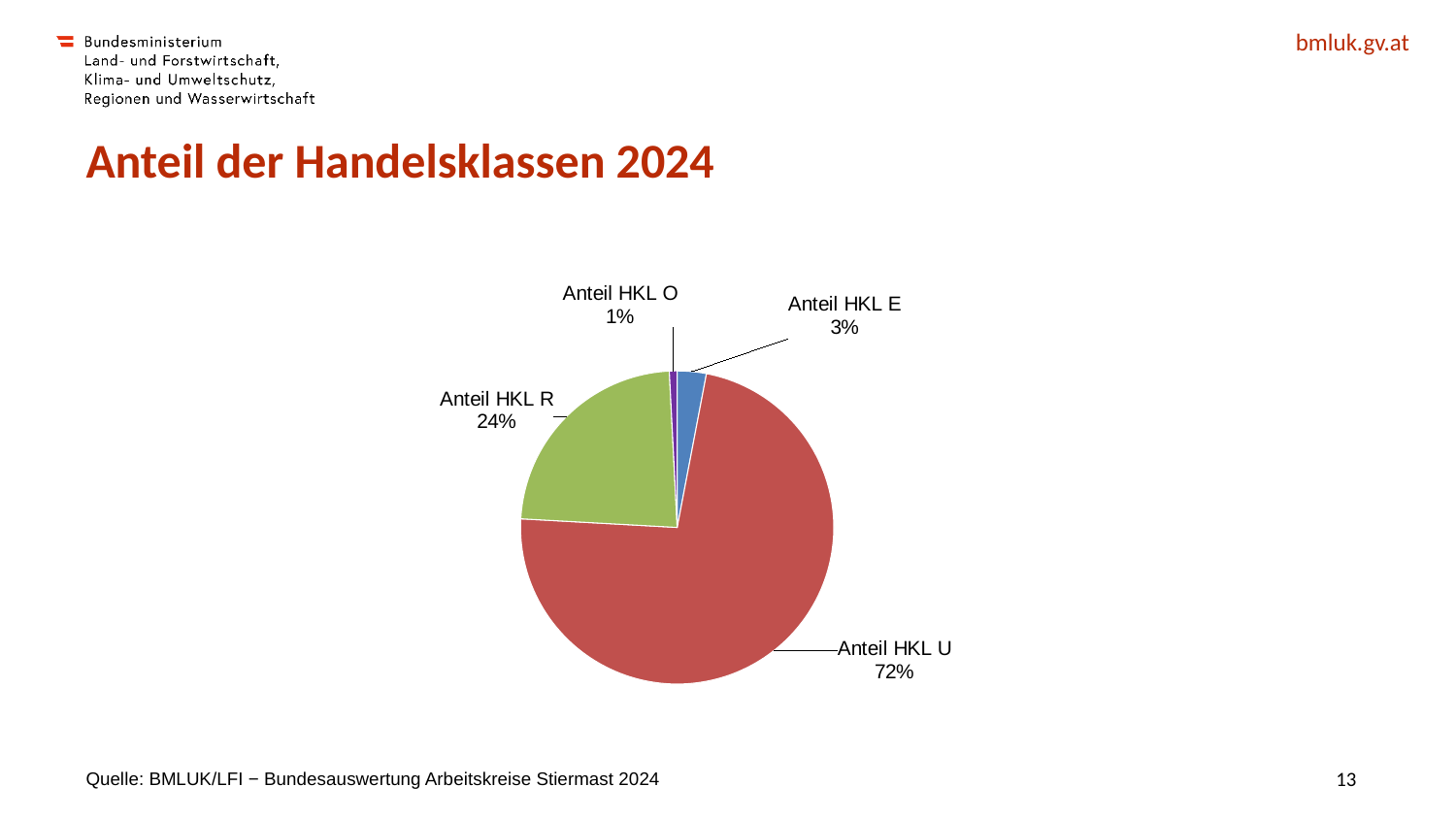
How many slices does the pie chart have? 4 What share does Anteil HKL E have in the pie chart? 3% What share does Anteil HKL R have in the pie chart? 24% What is the title of the slide containing the pie chart? Anteil der Handelsklassen 2024 Which slice of the pie chart is the largest? Anteil HKL U What share does Anteil HKL O have in the pie chart? 1% What share does Anteil HKL U have in the pie chart? 72% What is the difference in percentage points between Anteil HKL U and Anteil HKL R? 48 What kind of chart is shown on the slide? pie chart Which is larger, Anteil HKL E or Anteil HKL O? Anteil HKL E What colour is the Anteil HKL R slice in the pie chart? green Which slice of the pie chart is the smallest? Anteil HKL O